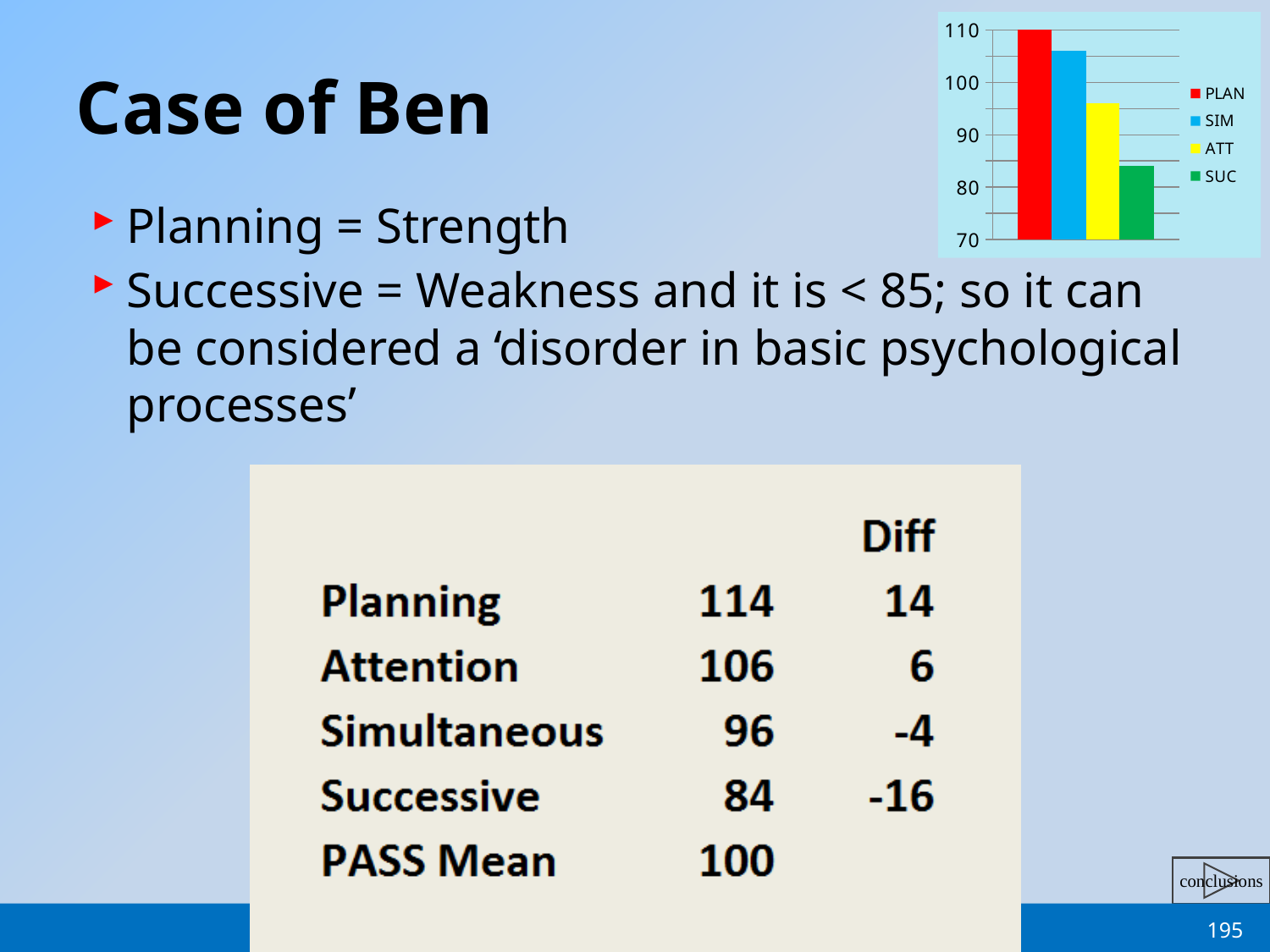
Which is larger in the chart, SIM or ATT? SIM Which series has the tallest bar in the chart? PLAN Which series has the shortest bar in the chart? SUC How many series does the chart legend list? 4 How many bars are plotted in the chart? 4 Is the value for PLAN greater or less than 100? greater Is the value for ATT greater or less than 90? greater What kind of chart is shown on the slide? bar chart What colour is the PLAN bar in the chart? red Do the bar values rise or fall from left to right across the chart? fall Is the value for SIM greater or less than 100? greater